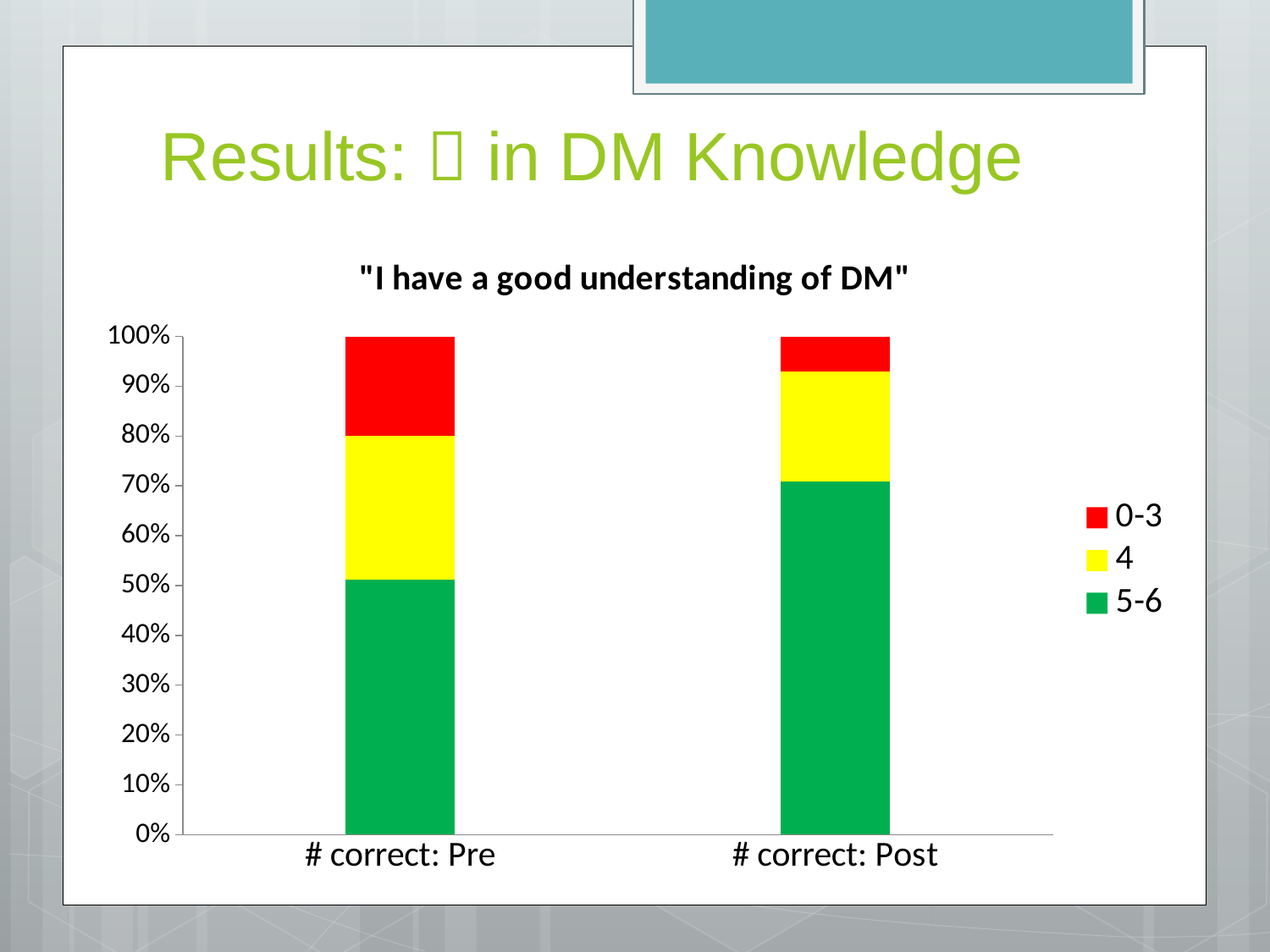
How many categories are shown on the x axis? 2 Which legend entry is shown in green? 5-6 What kind of chart is shown on the slide? stacked bar chart Is the 5-6 share for "# correct: Pre" greater or less than 60%? less What is the title of the chart? "I have a good understanding of DM" Is the 5-6 share for "# correct: Post" greater or less than 60%? greater What is the total height of the stacked bar for "# correct: Post"? 100% Which category has the larger 5-6 share, "# correct: Pre" or "# correct: Post"? # correct: Post Which category has the larger 0-3 share, "# correct: Pre" or "# correct: Post"? # correct: Pre How many series does the legend list? 3 Does the top of the 5-6 segment for "# correct: Pre" sit above or below 40%? above Does the 5-6 share rise or fall from "# correct: Pre" to "# correct: Post"? rise